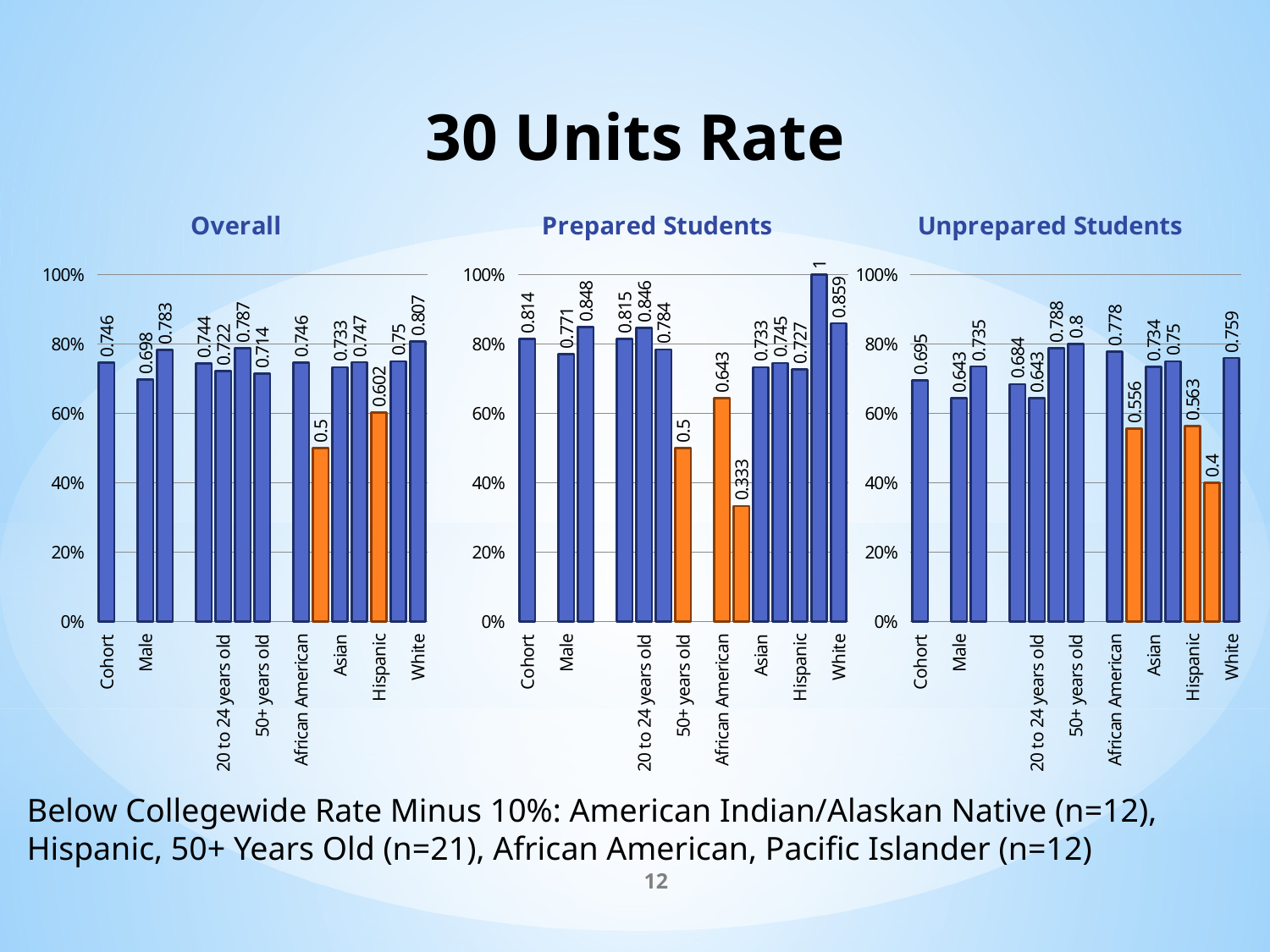
In the Overall chart, what is the value for Cohort? 0.746 In the Prepared Students chart, what is the value for Hispanic? 0.727 In the Prepared Students chart, what is the difference between the White value and the Cohort value? 0.045 How many bars are plotted in the Overall chart? 14 What is the title of the middle chart on the slide? Prepared Students In the Overall chart, which is higher, Male or White? White What kind of chart is the Overall chart? bar chart In the Unprepared Students chart, what is the difference between the White value and the Cohort value? 0.064 In the Unprepared Students chart, what is the value for 50+ years old? 0.8 In the Prepared Students chart, what is the value for African American? 0.643 In the Unprepared Students chart, is the value for Hispanic greater or less than 60%? less In the Unprepared Students chart, which is higher, Male or Asian? Asian